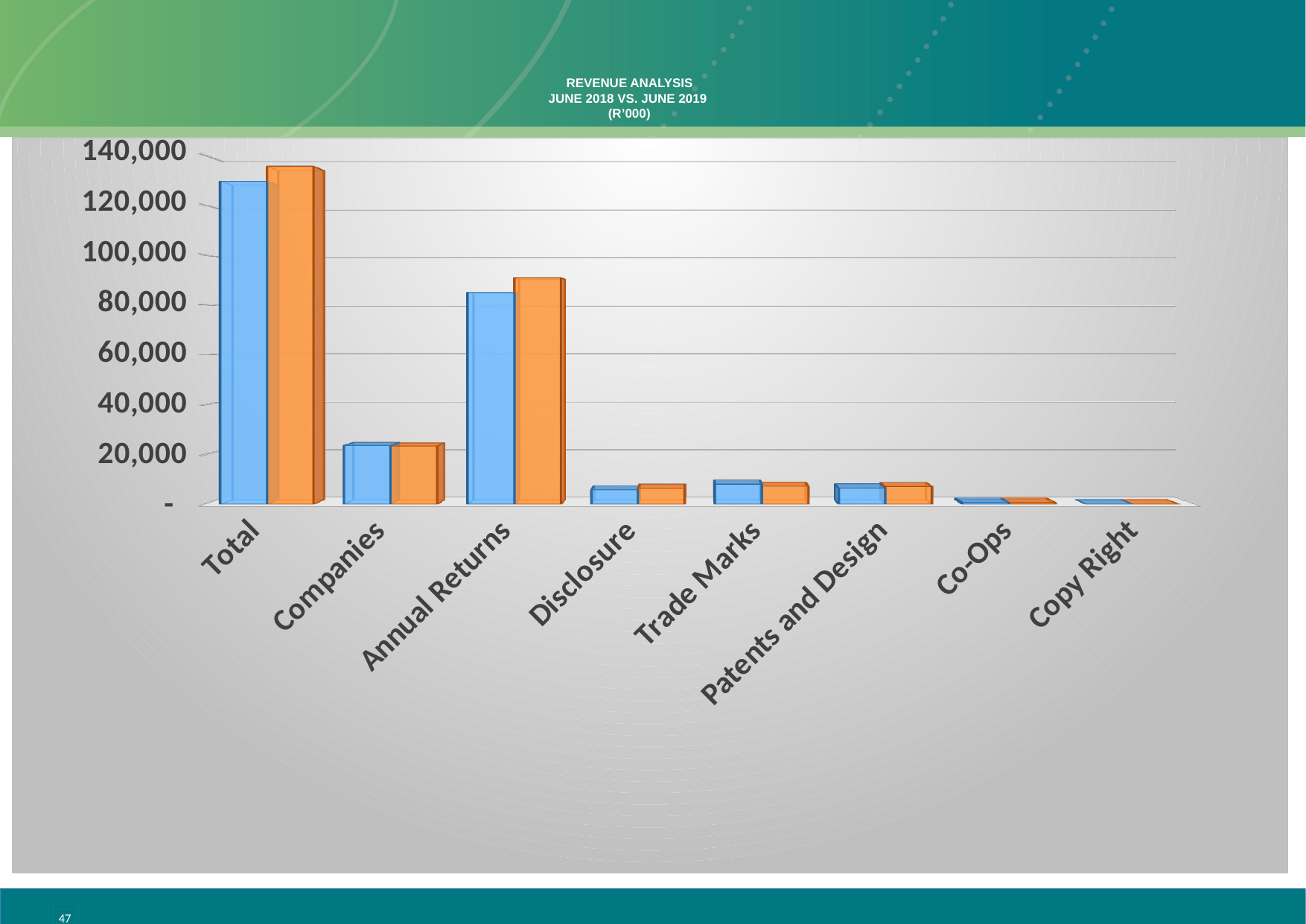
Which category has the highest bars in the chart? Total Which is larger, the bar for Annual Returns or the bar for Companies? Annual Returns What two colours are used for the bars in the chart? blue and orange Is the orange bar for Total greater or less than 140,000? less Is the blue bar for Disclosure greater or less than 20,000? less Is the blue bar for Annual Returns greater or less than 60,000? greater What kind of chart is shown on the slide? bar chart What is the title of the chart on the slide? REVENUE ANALYSIS JUNE 2018 VS. JUNE 2019 (R'000) How many categories are shown on the x axis of the chart? 8 For the Total category, which bar is taller, the blue one or the orange one? the orange one